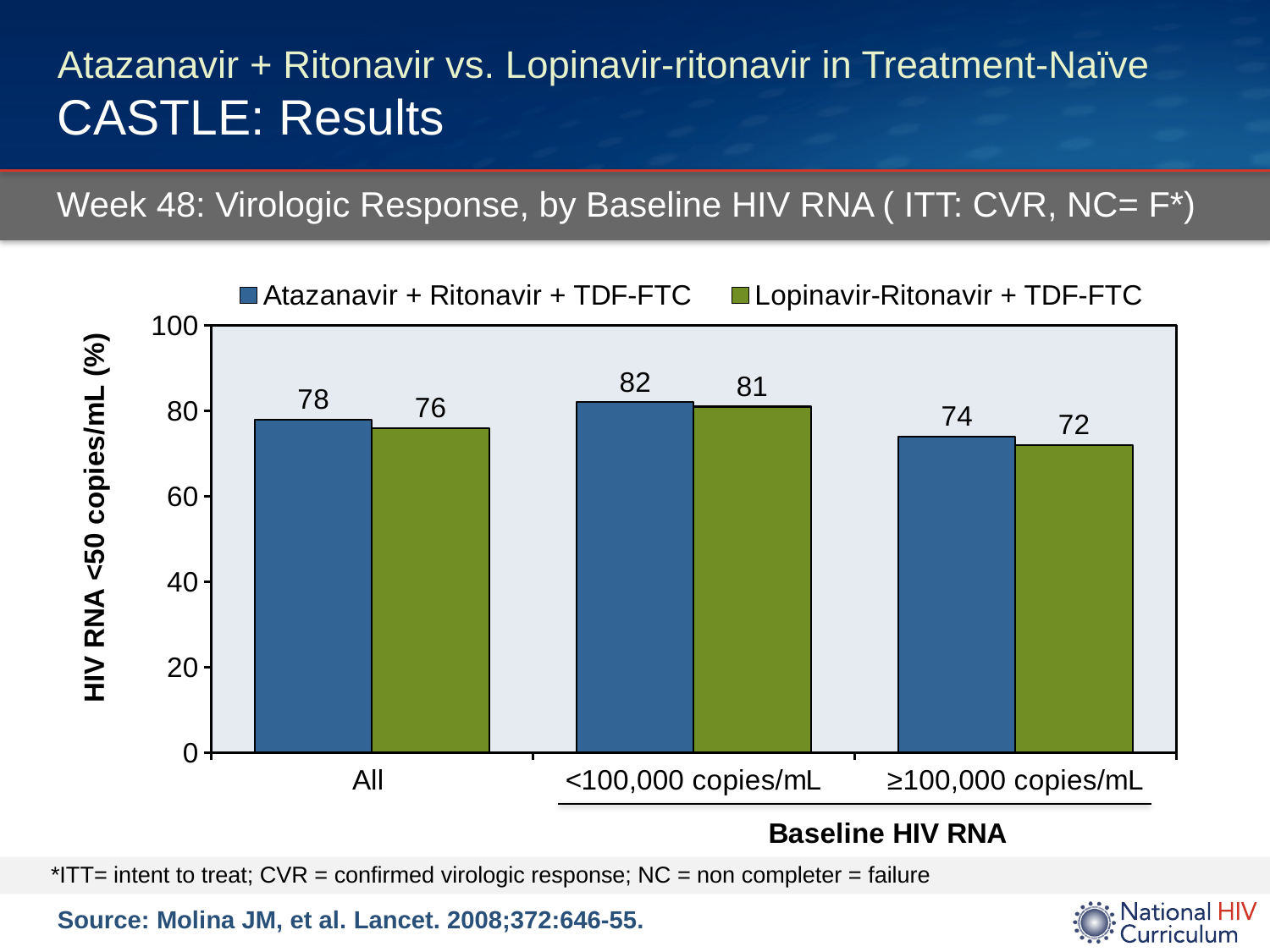
Which category has the highest value for Atazanavir + Ritonavir + TDF-FTC? <100,000 copies/mL What is the difference between the Atazanavir + Ritonavir + TDF-FTC and Lopinavir-Ritonavir + TDF-FTC values in the All category? 2 Which category has the lowest value for Lopinavir-Ritonavir + TDF-FTC? ≥100,000 copies/mL What is the value for Lopinavir-Ritonavir + TDF-FTC in the ≥100,000 copies/mL category? 72 What is the value for Atazanavir + Ritonavir + TDF-FTC in the All category? 78 How many baseline HIV RNA categories are shown on the x axis? 3 What kind of chart is shown on the slide? Bar chart Which series has the larger value in the ≥100,000 copies/mL category? Atazanavir + Ritonavir + TDF-FTC How many series does the legend list? 2 What is the difference between the Atazanavir + Ritonavir + TDF-FTC values for <100,000 copies/mL and ≥100,000 copies/mL? 8 What is the label of the y axis? HIV RNA <50 copies/mL (%) What is the value for Lopinavir-Ritonavir + TDF-FTC in the <100,000 copies/mL category? 81